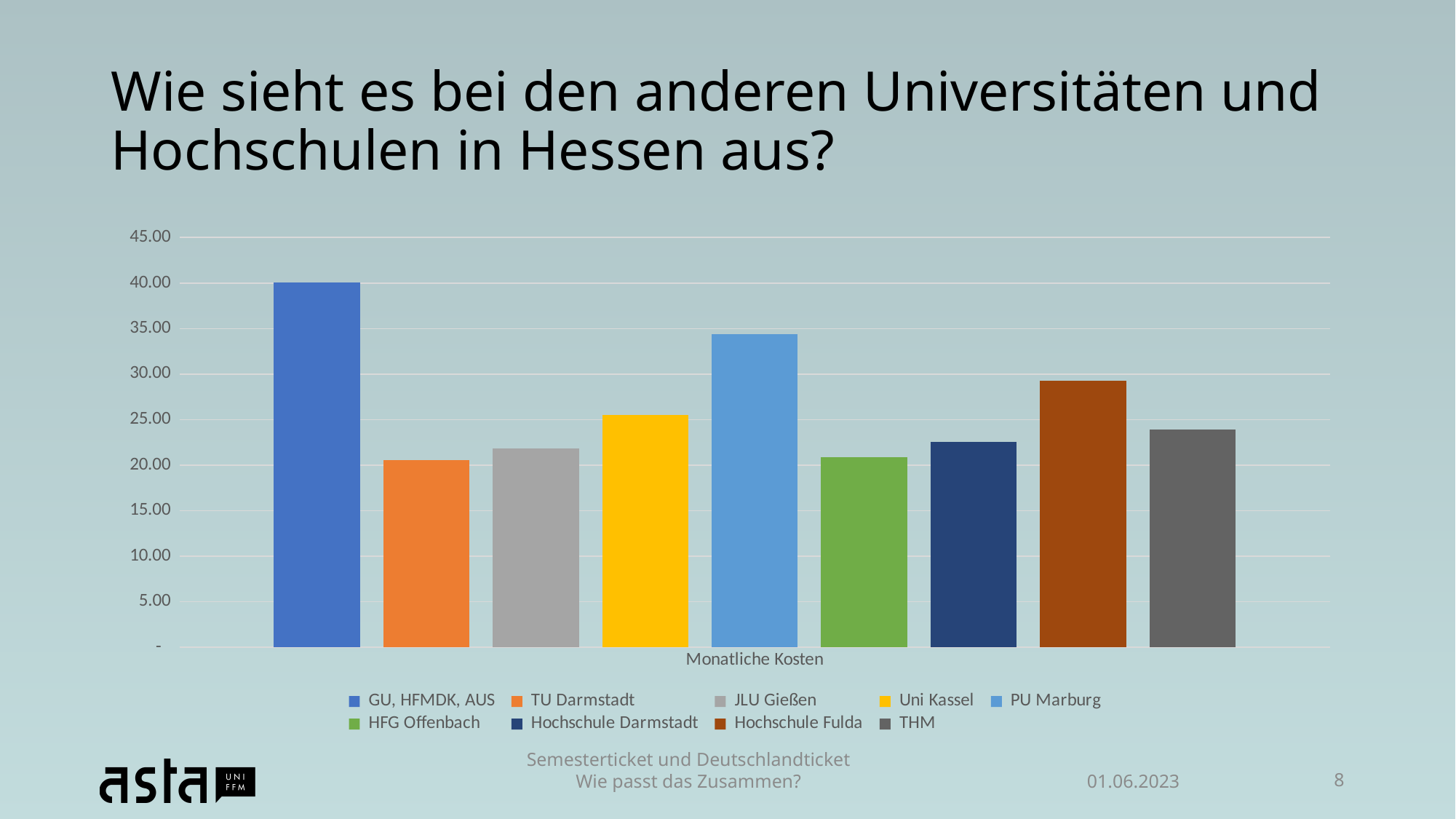
How many bars are plotted in the chart? 9 Which series has the highest monthly cost? GU, HFMDK, AUS Is the value for GU, HFMDK, AUS greater or less than 35.00? greater Is the value for PU Marburg greater or less than 30.00? greater What kind of chart is shown on the slide? bar chart Which is larger, the value for Uni Kassel or the value for JLU Gießen? Uni Kassel Is the value for Hochschule Darmstadt greater or less than 20.00? greater Which is larger, the value for PU Marburg or the value for Hochschule Fulda? PU Marburg What is the label shown on the x axis of the chart? Monatliche Kosten How many series does the legend list? 9